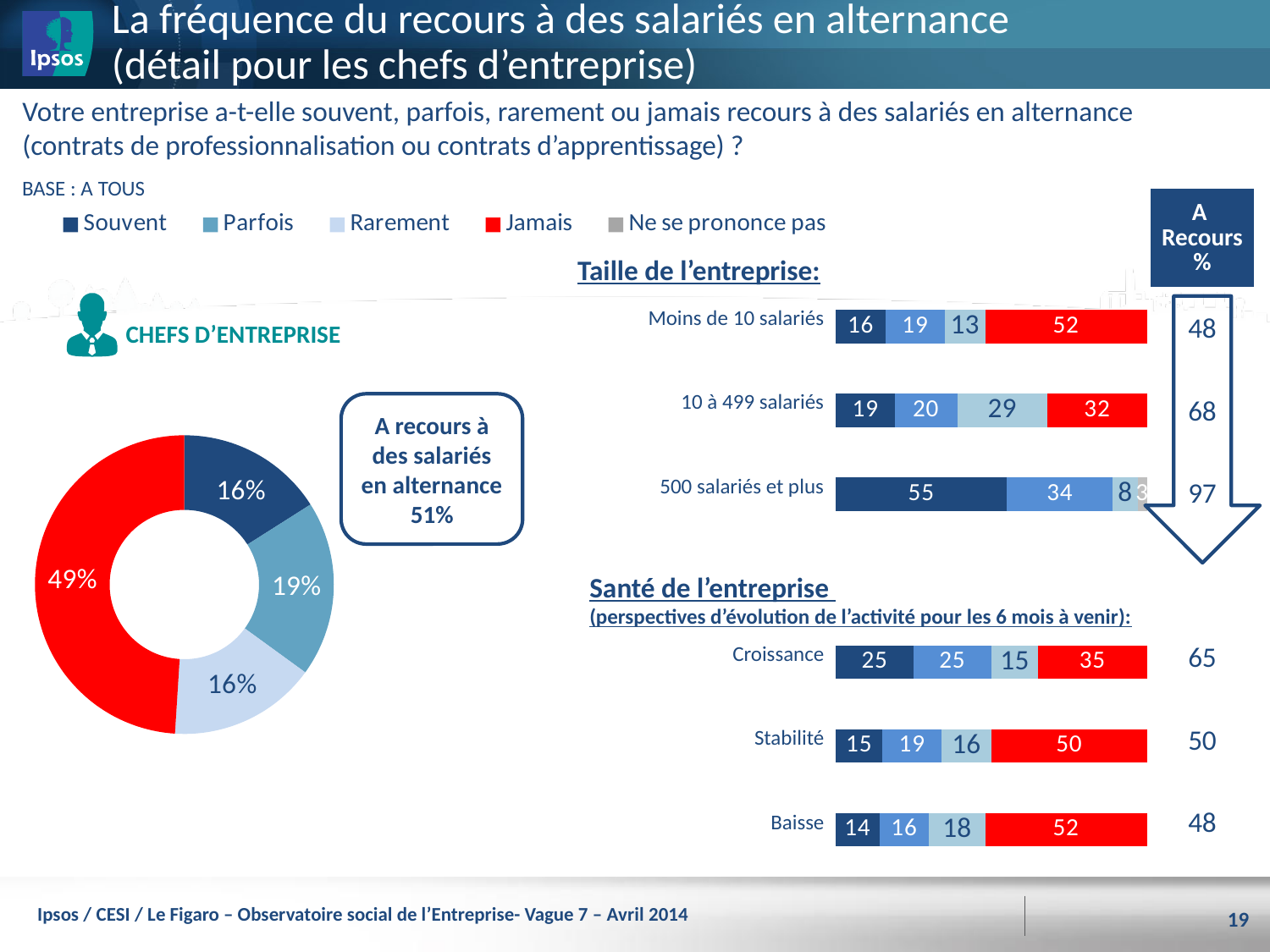
In the 'Santé de l'entreprise' bar chart, what is the 'Jamais' value for 'Stabilité'? 50 In the donut chart for Chefs d'entreprise, what percentage answered 'Parfois'? 19% In the 'Taille de l'entreprise' bar chart, which company size has the highest 'A Recours %' value? 500 salariés et plus In the donut chart for Chefs d'entreprise, which response has the largest slice? Jamais In the 'Taille de l'entreprise' bar chart, what is the 'Jamais' value for 'Moins de 10 salariés'? 52 In the donut chart for Chefs d'entreprise, what share of respondents answered 'Jamais'? 49% In the 'Taille de l'entreprise' bar chart, what is the 'Souvent' value for '500 salariés et plus'? 55 In the 'Santé de l'entreprise' bar chart, which is larger: the 'Souvent' value for 'Croissance' or for 'Baisse'? Croissance In the 'Taille de l'entreprise' bar chart, what is the difference between the 'Rarement' values for '10 à 499 salariés' and 'Moins de 10 salariés'? 16 How many categories are shown in the 'Santé de l'entreprise' bar chart? 3 In the 'Santé de l'entreprise' bar chart, what is the 'A Recours %' value for 'Baisse'? 48 How many series does the legend at the top of the slide list? 5